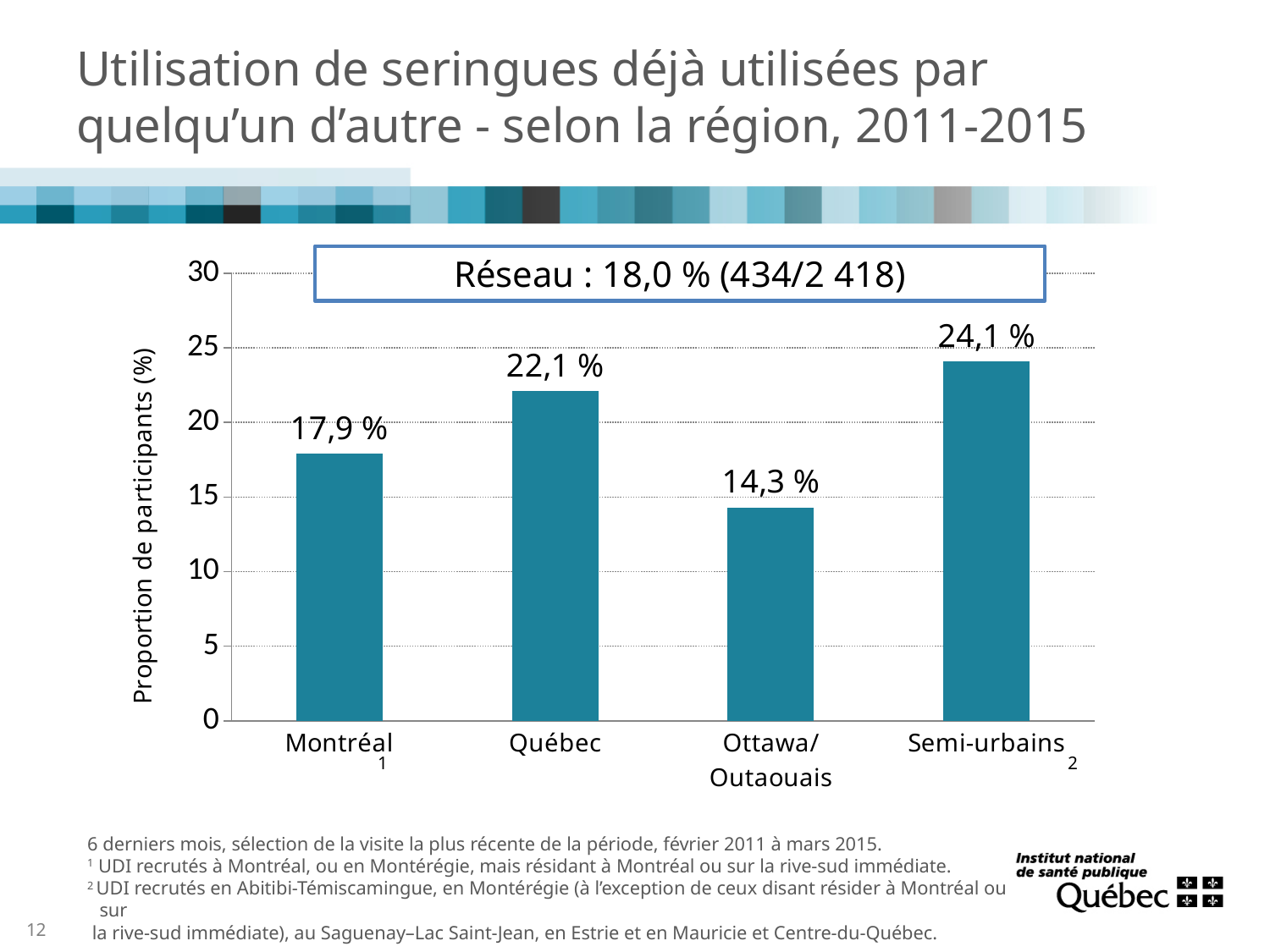
What is the value for Semi-urbains? 24,1 % What is the value for Québec? 22,1 % Which is larger, the value for Québec or the value for Montréal? Québec Which region has the lowest value? Ottawa/Outaouais Which region has the highest value? Semi-urbains How many regions are shown in the chart? 4 What is the value for Ottawa/Outaouais? 14,3 % What is the difference between the values for Semi-urbains and Ottawa/Outaouais? 9,8 % Is the value for Québec greater or less than 20? greater What overall network (Réseau) value is shown in the box above the chart? 18,0 % (434/2 418) What kind of chart is shown on the slide? bar chart What is the value for Montréal? 17,9 %